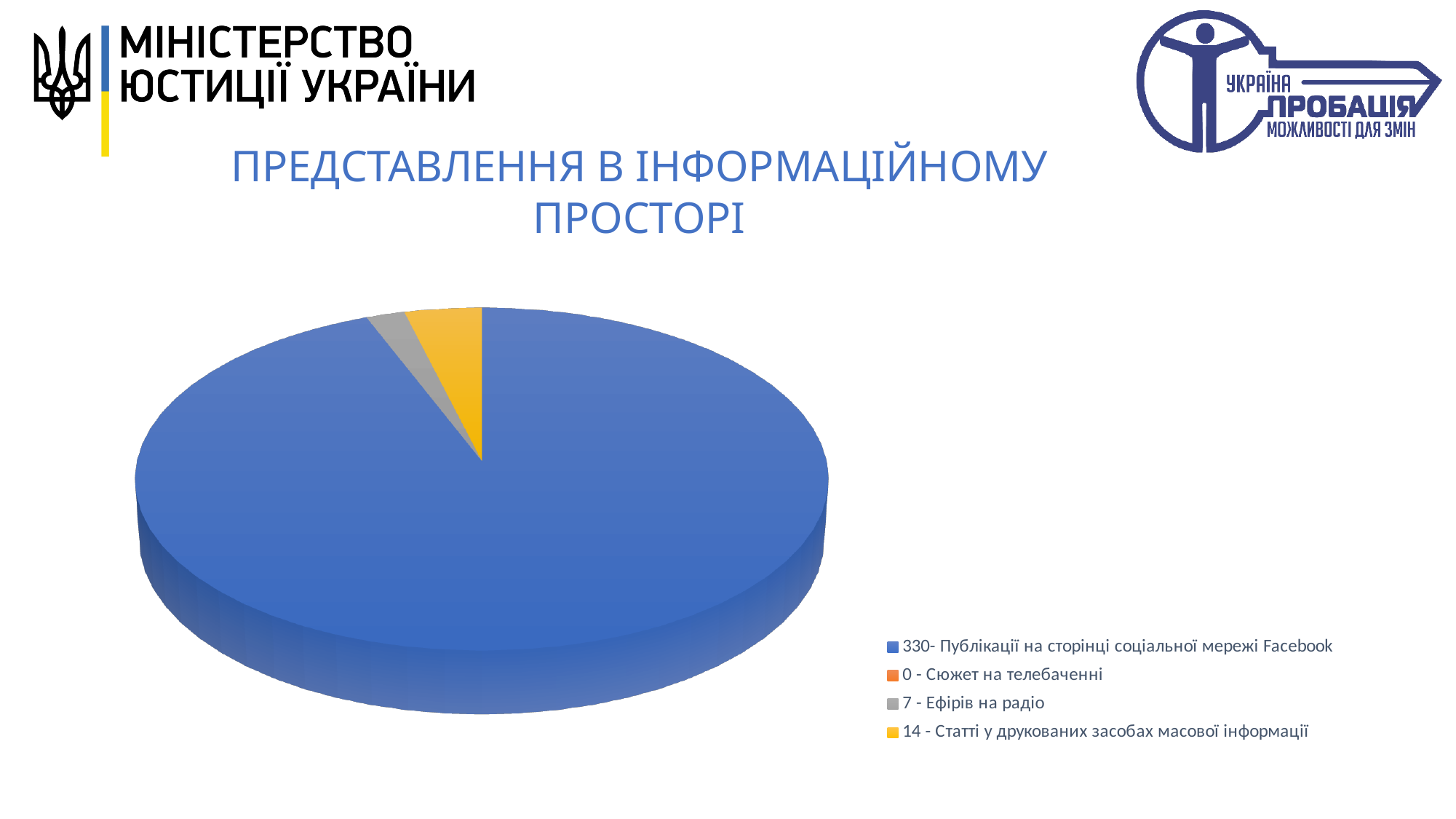
What is the difference between the number of print media articles and the number of radio broadcasts? 7 What kind of chart is shown on the slide? pie chart What value is given for articles in print mass media (Статті у друкованих засобах масової інформації)? 14 What is the total of all four values listed in the legend? 351 What value is given for publications on the Facebook social network page (Публікації на сторінці соціальної мережі Facebook)? 330 What colour is the slice for Facebook publications? blue What value is given for radio broadcasts (Ефірів на радіо)? 7 Which is larger: the number of radio broadcasts or the number of print media articles? Статті у друкованих засобах масової інформації How many categories does the legend of the pie chart list? 4 Which category has the smallest value in the pie chart? Сюжет на телебаченні What value is given for TV stories (Сюжет на телебаченні)? 0 Which category has the largest value in the pie chart? Публікації на сторінці соціальної мережі Facebook